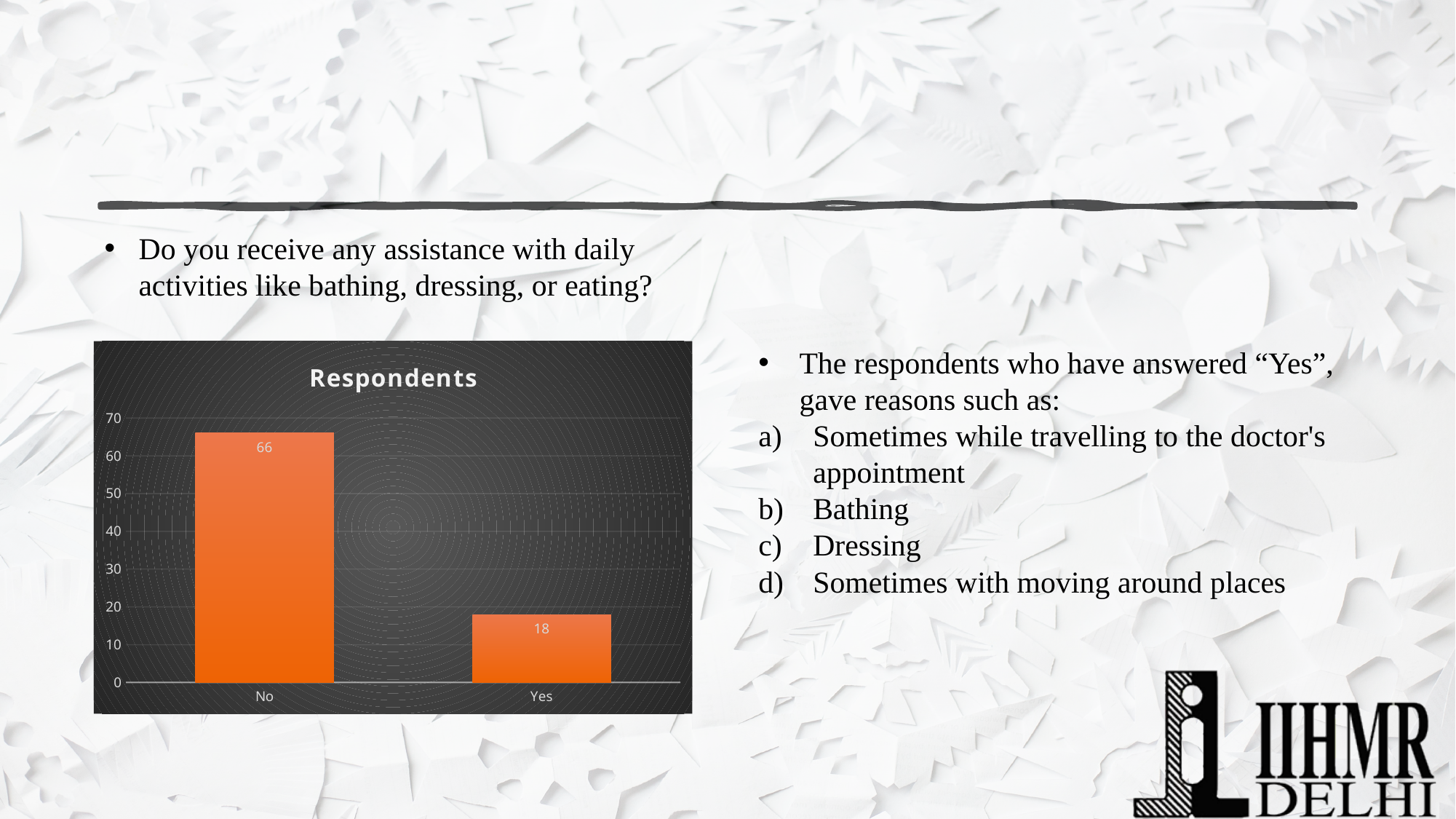
What is the title of the chart on the slide? Respondents What is the value for "No" in the Respondents chart? 66 Is the value for "No" in the Respondents chart greater or less than 60? greater Which is larger in the Respondents chart, the value for "No" or the value for "Yes"? No What is the total of the two values shown in the Respondents chart? 84 What is the value for "Yes" in the Respondents chart? 18 How many categories are shown in the Respondents chart? 2 What is the difference between the values for "No" and "Yes" in the Respondents chart? 48 What kind of chart is the Respondents chart? bar chart Which category has the highest value in the Respondents chart? No Which category has the lowest value in the Respondents chart? Yes Is the value for "Yes" in the Respondents chart greater or less than 20? less